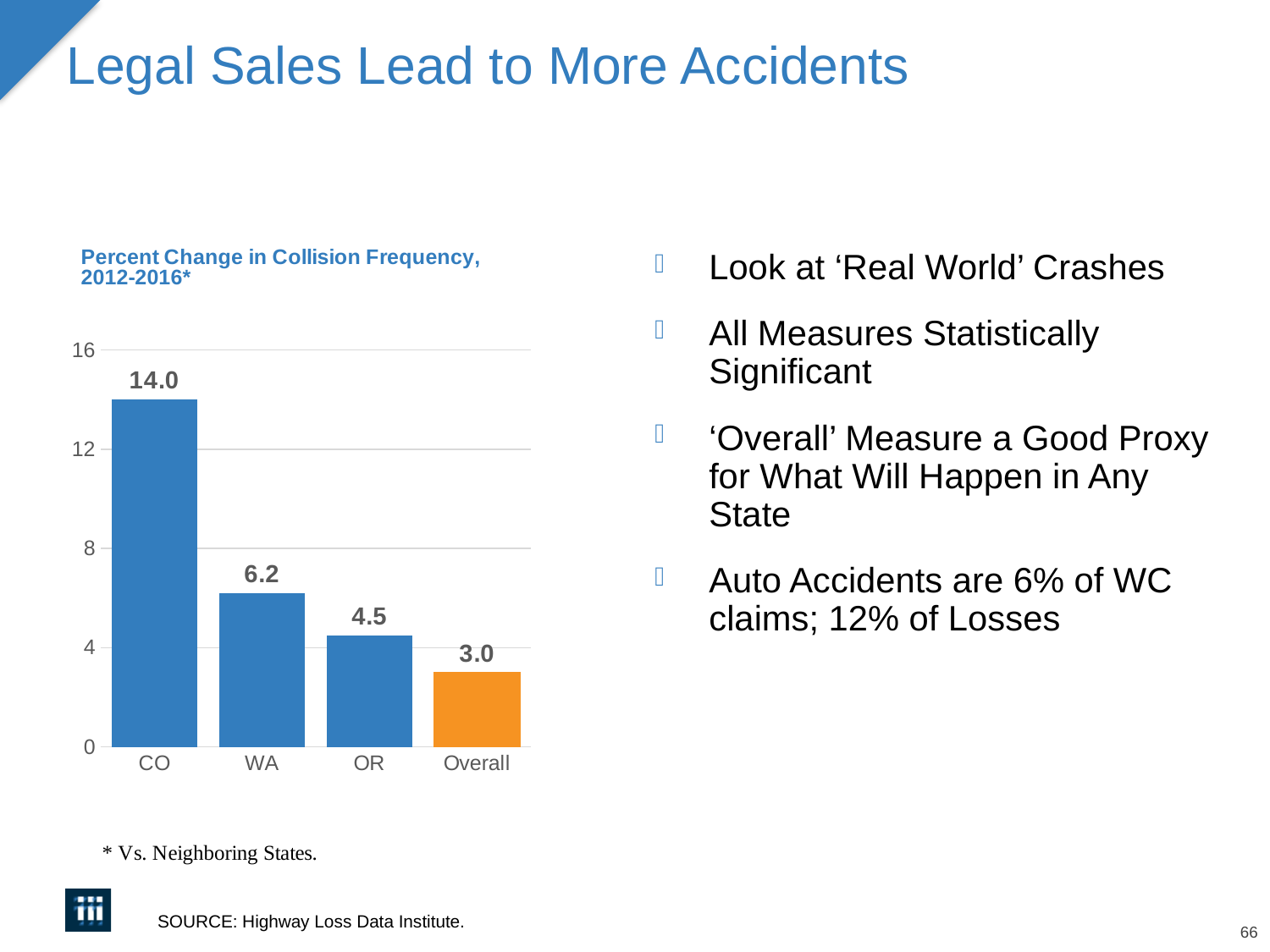
What is the value shown for OR? 4.5 What is the value shown for WA? 6.2 Which category has the highest percent change in collision frequency? CO Which bar in the chart is coloured orange rather than blue? Overall What is the percent change in collision frequency for CO? 14.0 Which category has the lowest value in the chart? Overall What is the value shown for the Overall bar? 3.0 What kind of chart is shown on the slide? Bar chart Which is larger, the value for WA or the value for OR? WA What is the difference between the values for OR and Overall? 1.5 How many categories are shown in the chart? 4 What is the difference between the values for CO and WA? 7.8